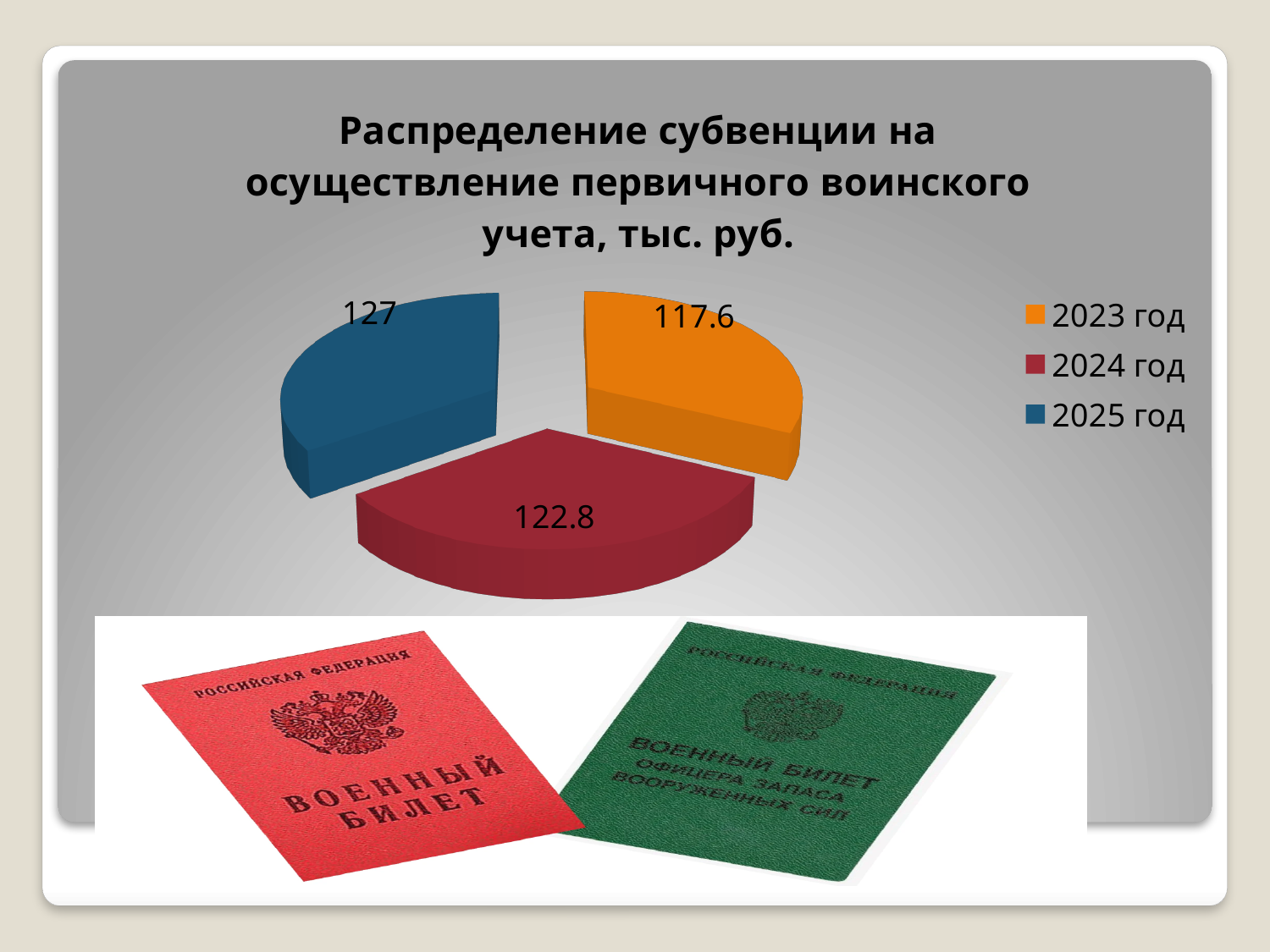
What is the difference between the values for 2025 год and 2023 год? 9.4 How many slices does the pie chart have? 3 What kind of chart is shown on the slide? Pie chart Which year has the largest slice in the pie chart? 2025 год Which is larger, the value for 2024 год or the value for 2023 год? 2024 год What is the difference between the values for 2024 год and 2023 год? 5.2 What is the value for 2023 год in the pie chart? 117.6 What is the value for 2024 год in the pie chart? 122.8 How many entries does the legend list? 3 What colour is the slice for 2024 год? Red What is the value for 2025 год in the pie chart? 127 Which year has the smallest slice in the pie chart? 2023 год